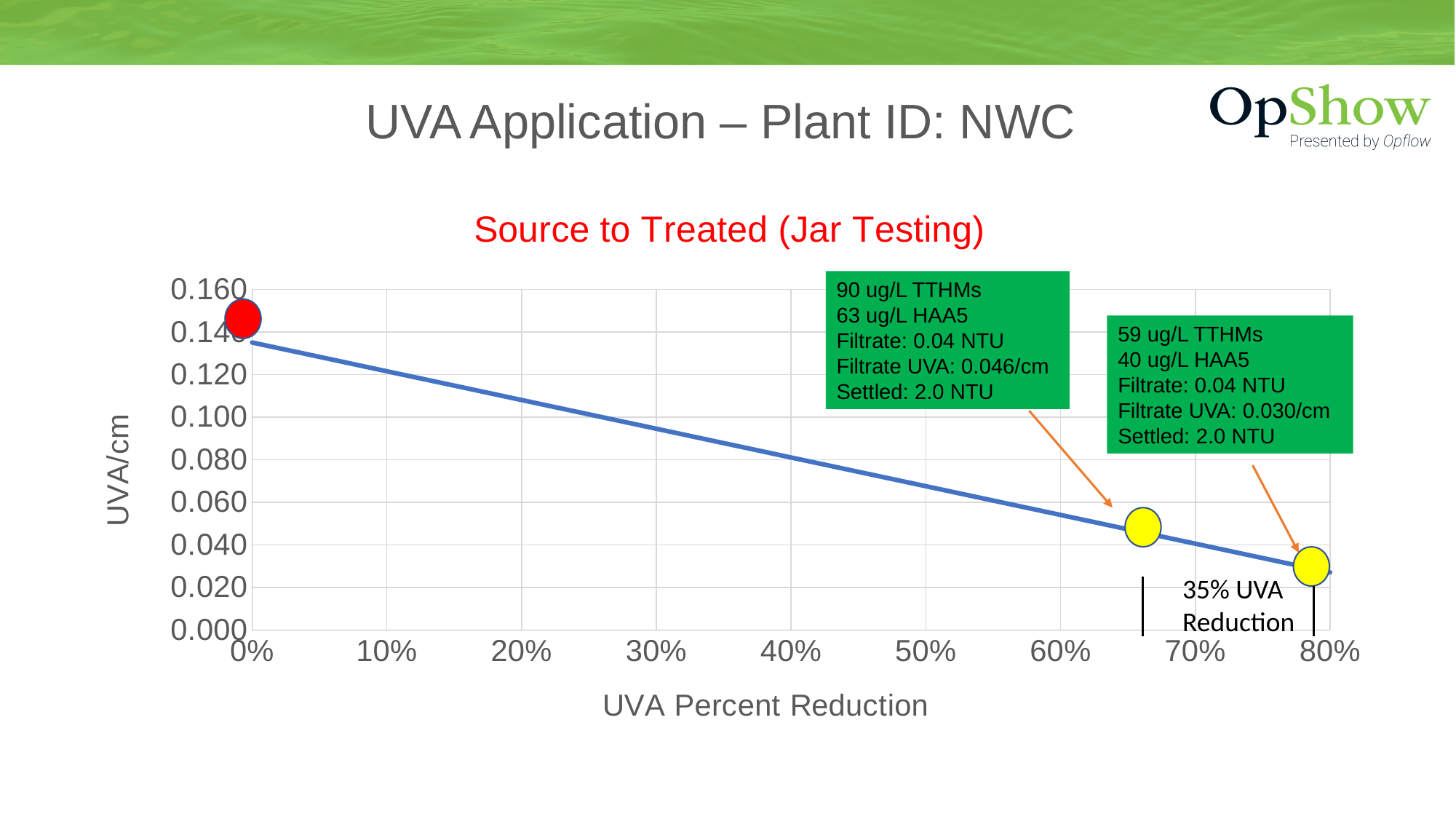
According to the first green callout, what is the Filtrate UVA for the yellow point near 65% reduction? 0.046/cm How many highlighted data points (circles) are marked on the line? 3 Which point has the higher UVA/cm value: the red point at 0% reduction or the yellow point near 80% reduction? the red point at 0% According to the second green callout, what is the TTHMs value for the rightmost yellow point? 59 ug/L What is the title of the chart? Source to Treated (Jar Testing) What is the label of the x axis? UVA Percent Reduction Is the UVA/cm value of the rightmost yellow point greater or less than 0.040? less Is the UVA/cm value of the red point at 0% reduction greater or less than 0.120? greater Is the UVA/cm value of the yellow point near 65% reduction greater or less than 0.080? less What is the difference in TTHMs between the first callout (90 ug/L) and the second callout (59 ug/L)? 31 ug/L Do the UVA/cm values rise or fall as UVA Percent Reduction increases along the x axis? fall What kind of chart is shown on the slide? line chart